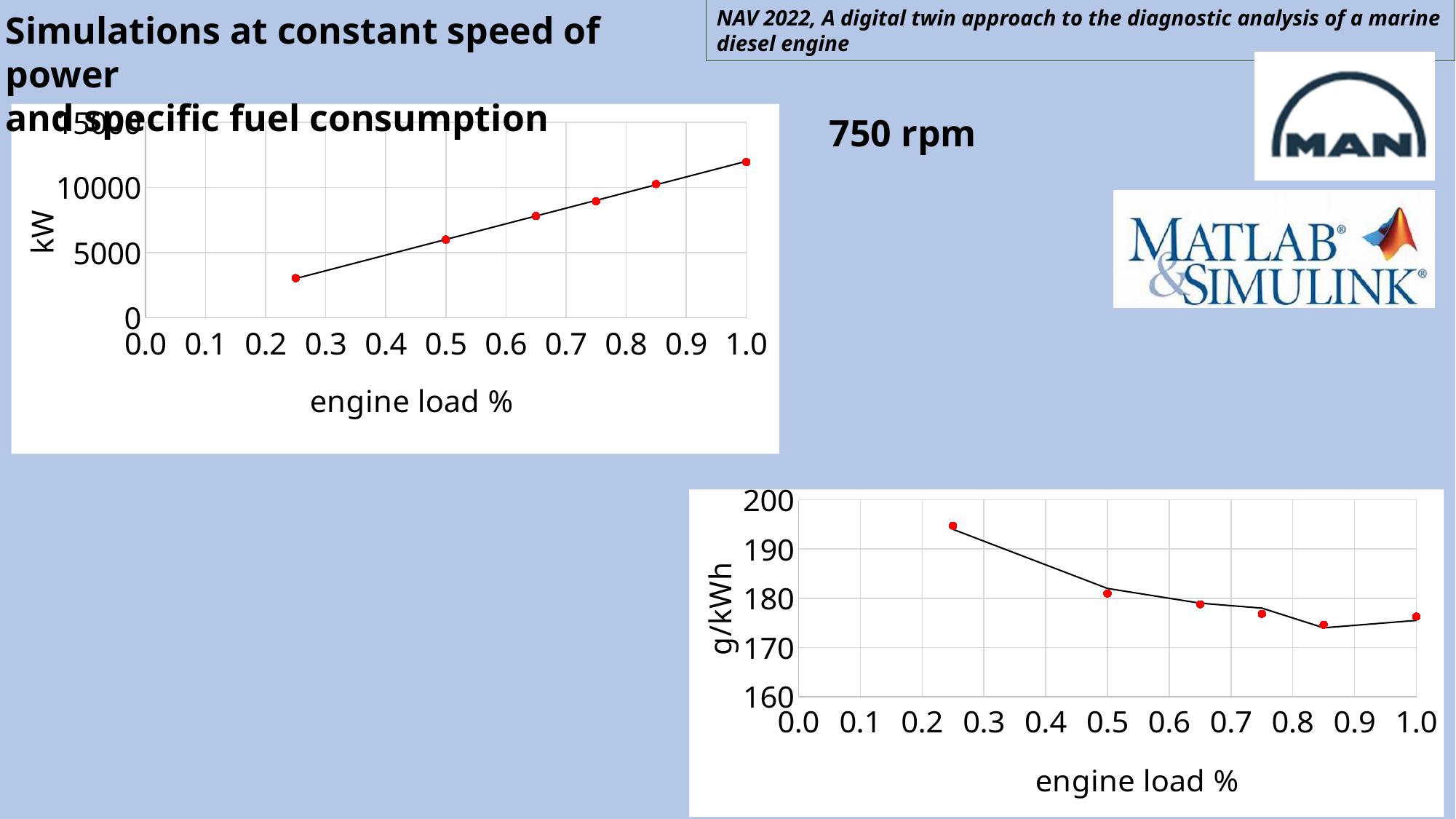
In the top-left chart (kW vs engine load), at which engine load is the power highest? 1.0 In the bottom-right chart (g/kWh vs engine load), is the value at engine load 1.0 greater or less than 180? less In the bottom-right chart (g/kWh vs engine load), what is the label of the x axis? engine load % In the bottom-right chart (g/kWh vs engine load), is the value at engine load 0.25 greater or less than 190? greater In the top-left chart (kW vs engine load), is the value at engine load 0.5 greater or less than 5000? greater In the bottom-right chart (g/kWh vs engine load), at which engine load is the specific fuel consumption lowest? 0.85 In the top-left chart (kW vs engine load), how many data points are plotted? 6 In the top-left chart (kW vs engine load), do the values rise or fall as engine load increases? rise In the bottom-right chart (g/kWh vs engine load), what kind of chart is it? line chart In the bottom-right chart (g/kWh vs engine load), at which engine load is the specific fuel consumption highest? 0.25